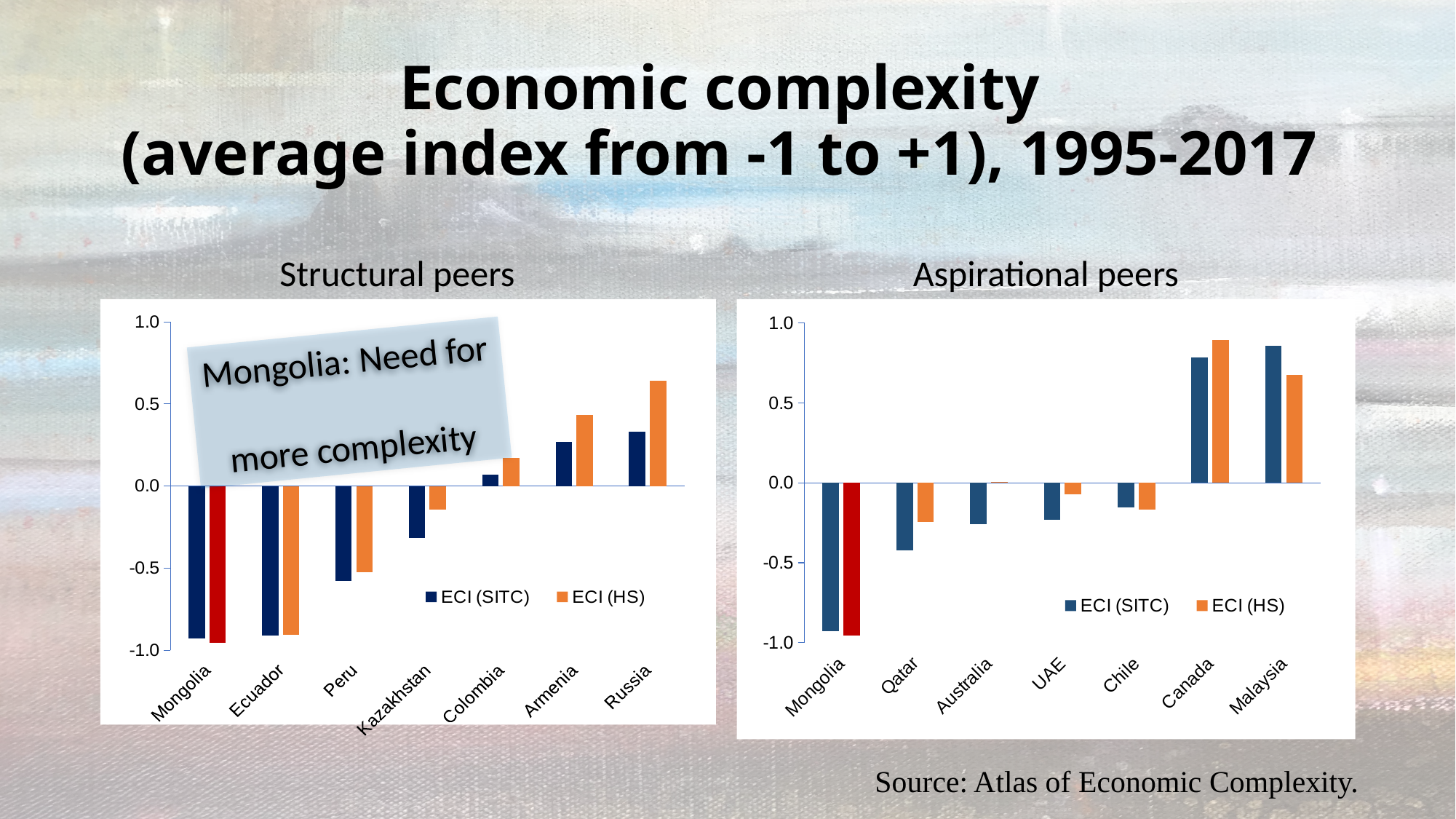
On the 'Structural peers' chart, which is larger: the ECI (HS) value for Armenia or for Russia? Russia On the 'Structural peers' chart, is the ECI (SITC) value for Mongolia greater or less than -0.5? less What are the two series named in the legend of the 'Aspirational peers' chart? ECI (SITC) and ECI (HS) On the 'Aspirational peers' chart, is the ECI (SITC) value for Malaysia greater or less than 0.5? greater On the 'Structural peers' chart, is the ECI (HS) value for Russia greater or less than 0.5? greater On the 'Structural peers' chart, do the values generally rise or fall from Mongolia to Russia along the x axis? rise On the 'Aspirational peers' chart, which country has the highest ECI (HS) value? Canada On the 'Structural peers' chart, which country has the highest ECI (HS) value? Russia What kind of chart is the 'Structural peers' chart? bar chart How many countries are shown on the 'Aspirational peers' chart? 7 On the 'Aspirational peers' chart, which country has the lowest ECI (SITC) value? Mongolia How many series does the legend of the 'Structural peers' chart list? 2